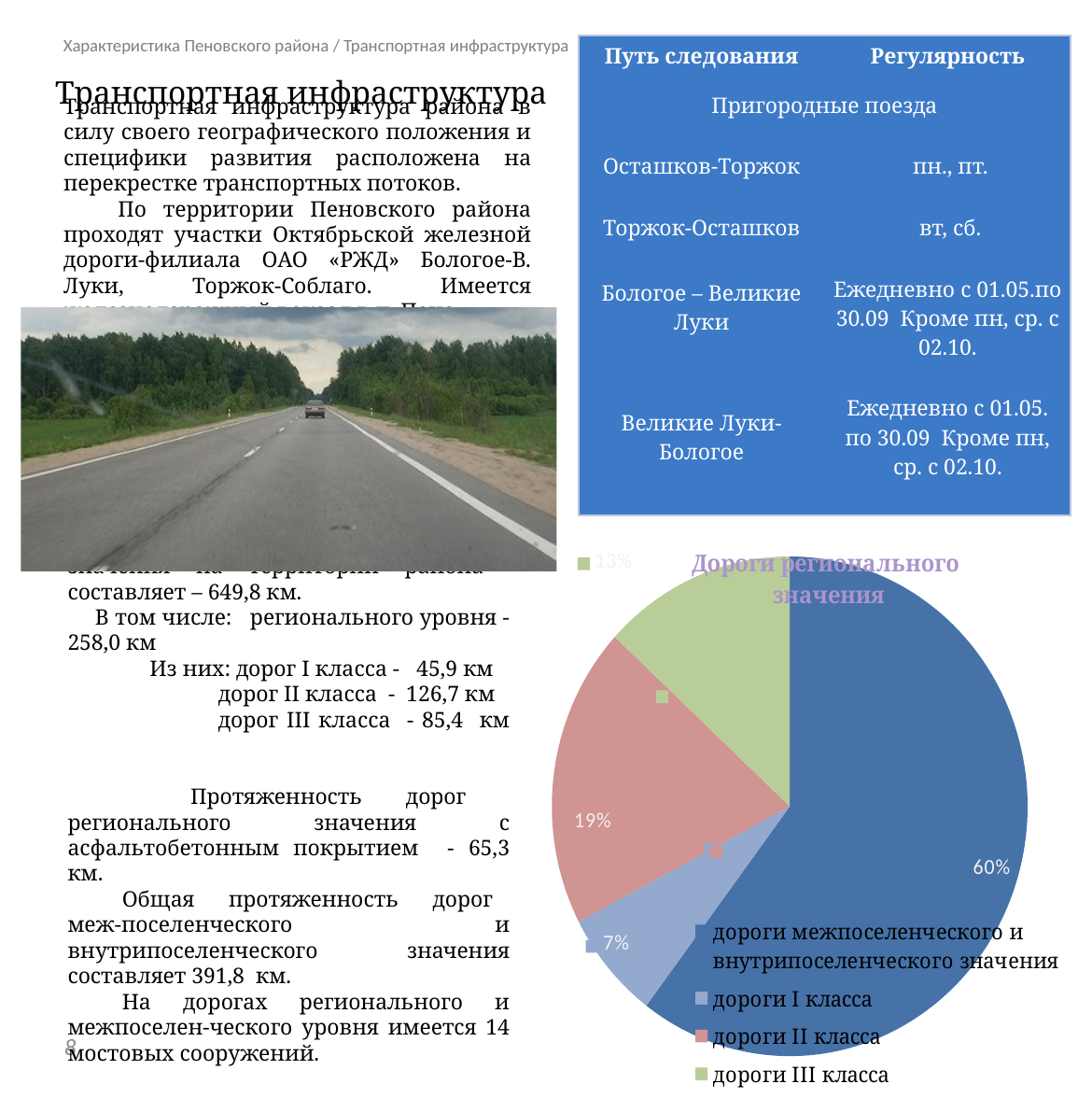
Which is larger: the slice for 'дороги II класса' or the slice for 'дороги I класса'? дороги II класса What share of the pie is 'дороги межпоселенческого и внутрипоселенческого значения'? 60% What share of the pie is 'дороги III класса'? 13% What share of the pie is 'дороги II класса'? 19% Which category has the smallest slice in the pie chart? дороги I класса What kind of chart is shown on the slide? pie chart Which category has the largest slice in the pie chart? дороги межпоселенческого и внутрипоселенческого значения What is the title of the pie chart? Дороги регионального значения What is the difference in percentage points between 'дороги II класса' and 'дороги III класса'? 6 How many entries does the pie chart's legend list? 4 How many slices does the pie chart have? 4